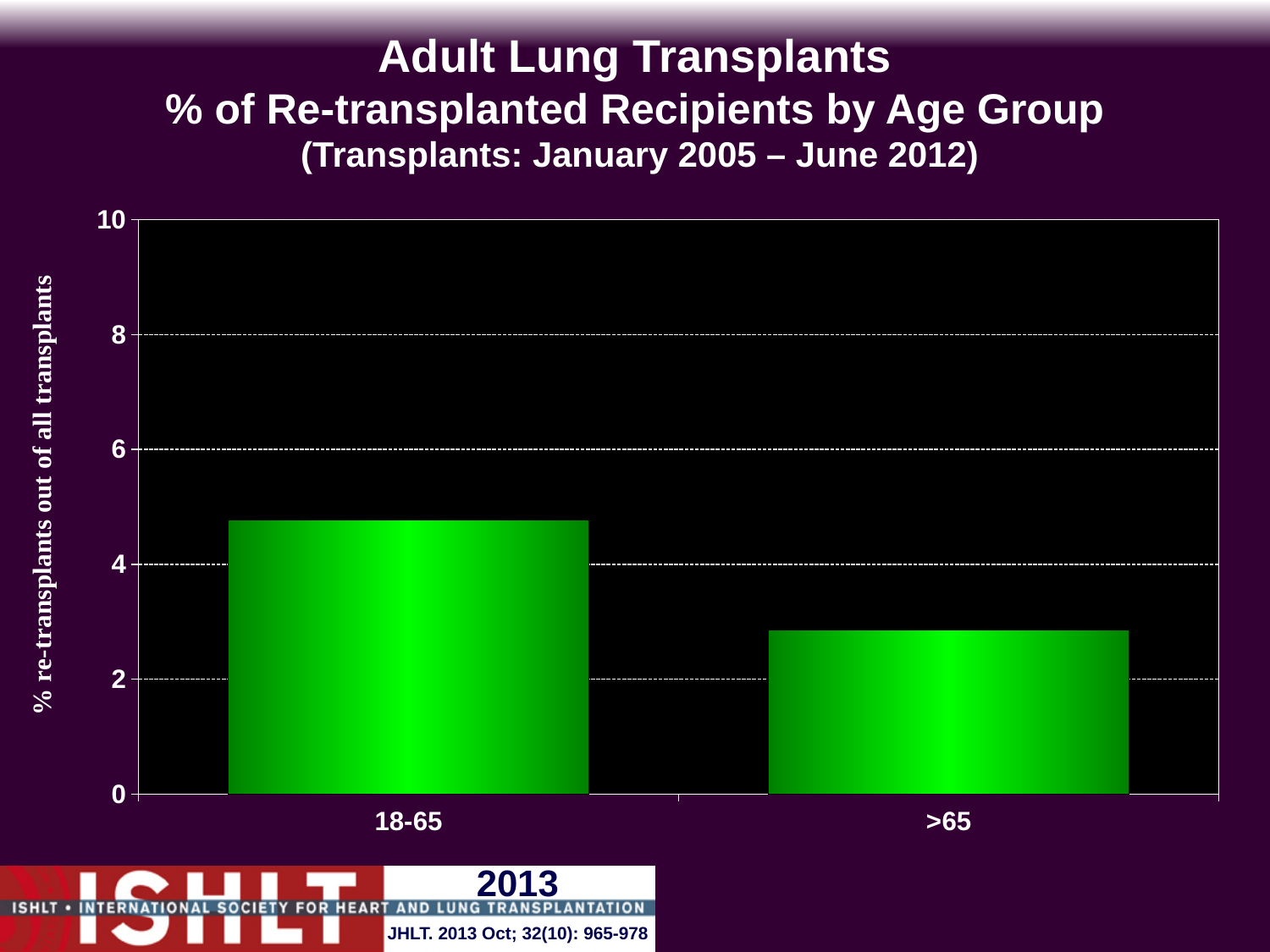
What is the label of the y axis? % re-transplants out of all transplants Is the value for the 18-65 age group greater or less than 4? greater Do the values rise or fall moving from the 18-65 group to the >65 group along the x axis? fall Which has a larger % of re-transplants, the 18-65 group or the >65 group? 18-65 Is the value for the >65 age group greater or less than 2? greater How many age group categories are plotted on the chart? 2 What kind of chart is shown on the slide? bar chart Which age group has the lowest % of re-transplants out of all transplants? >65 Is the value for the >65 age group greater or less than 4? less What time period of transplants does the chart title say is covered? January 2005 – June 2012 Which age group has the highest % of re-transplants out of all transplants? 18-65